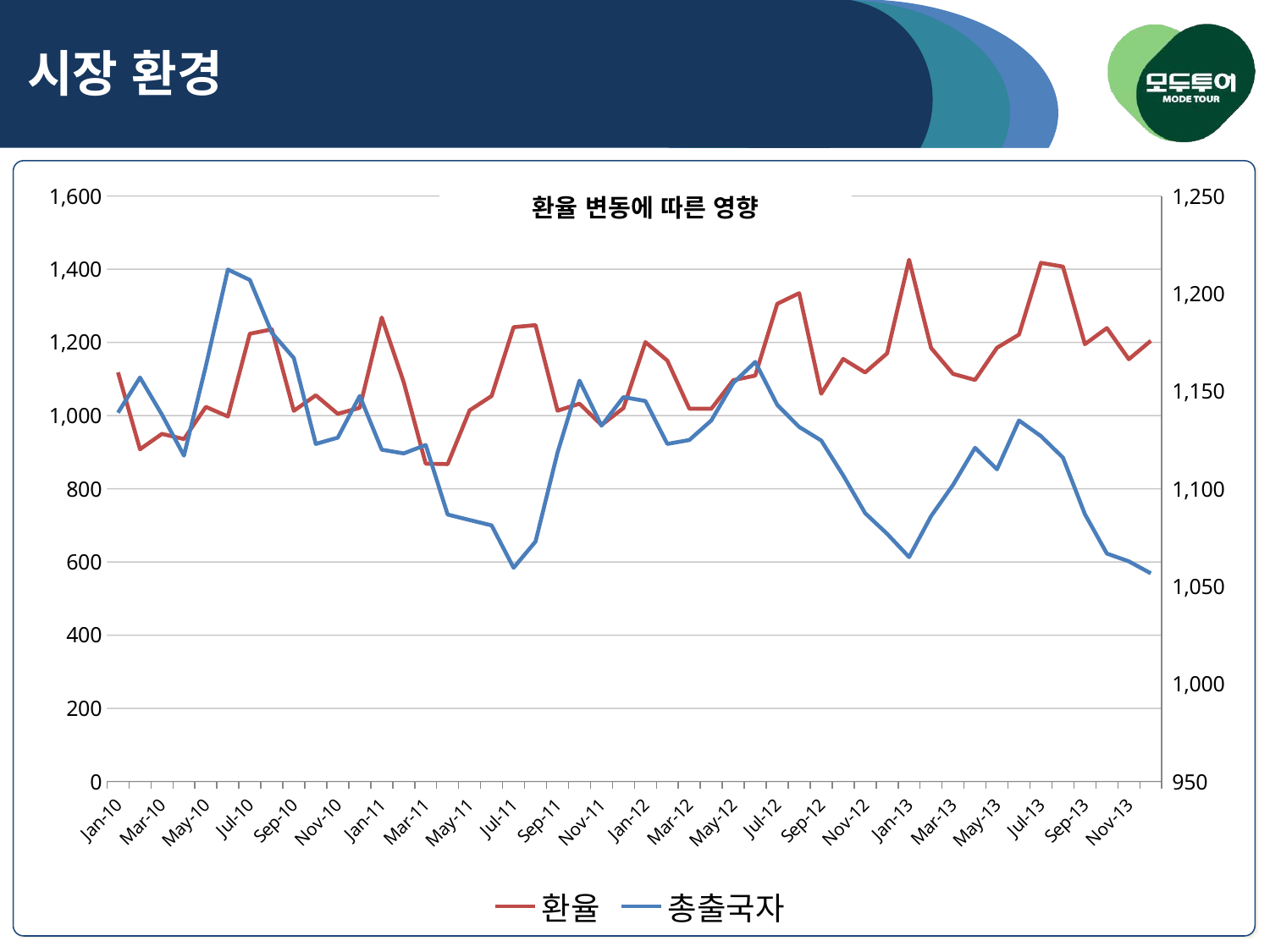
What is the title of the chart? 환율 변동에 따른 영향 Does the 환율 line rise or fall from Jul-13 to Nov-13? Falls Does the 총출국자 line rise or fall from Jul-13 to Nov-13? Falls How many month labels are shown along the x axis? 24 Is the 총출국자 line at Jul-11 above or below the 800 gridline of the left-hand axis? Below Which is higher on the chart: the 환율 line at Jan-13 or at Sep-12? Jan-13 Which is higher on the chart: the 총출국자 line at Jul-10 or at Jul-11? Jul-10 Is the 총출국자 line at Jul-10 above or below the 1,200 gridline of the left-hand axis? Above Which series is drawn in blue? 총출국자 How many series does the legend list? 2 Does the 환율 line rise or fall from Sep-12 to Jan-13? Rises What kind of chart is shown on the slide? Line chart